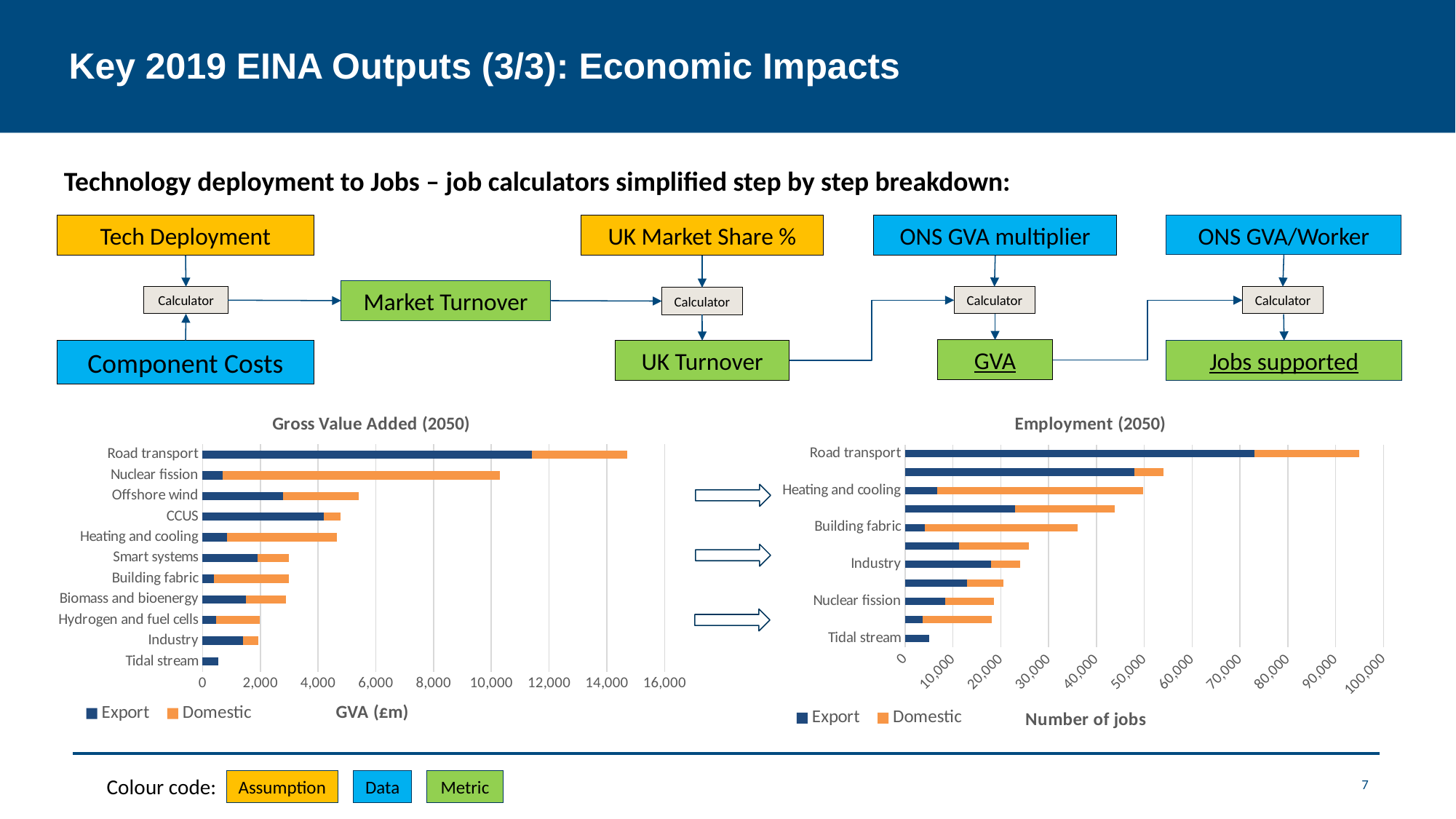
What is the x-axis label of the Gross Value Added (2050) chart? GVA (£m) How many series does the legend of the Employment (2050) chart list? 2 In the Gross Value Added (2050) chart, is the total value for Tidal stream greater or less than 2,000? less How many categories are shown on the Gross Value Added (2050) chart? 11 In the Gross Value Added (2050) chart, which category has the lowest total GVA? Tidal stream In the Employment (2050) chart, which category has the highest total number of jobs? Road transport In the Gross Value Added (2050) chart, which has the larger total GVA, Offshore wind or CCUS? Offshore wind In the Employment (2050) chart, is the total value for Road transport greater or less than 90,000? greater In the Employment (2050) chart, is the total value for Tidal stream greater or less than 10,000? less In the Gross Value Added (2050) chart, which category has the highest total GVA? Road transport What kind of chart is the Gross Value Added (2050) chart? Stacked bar chart